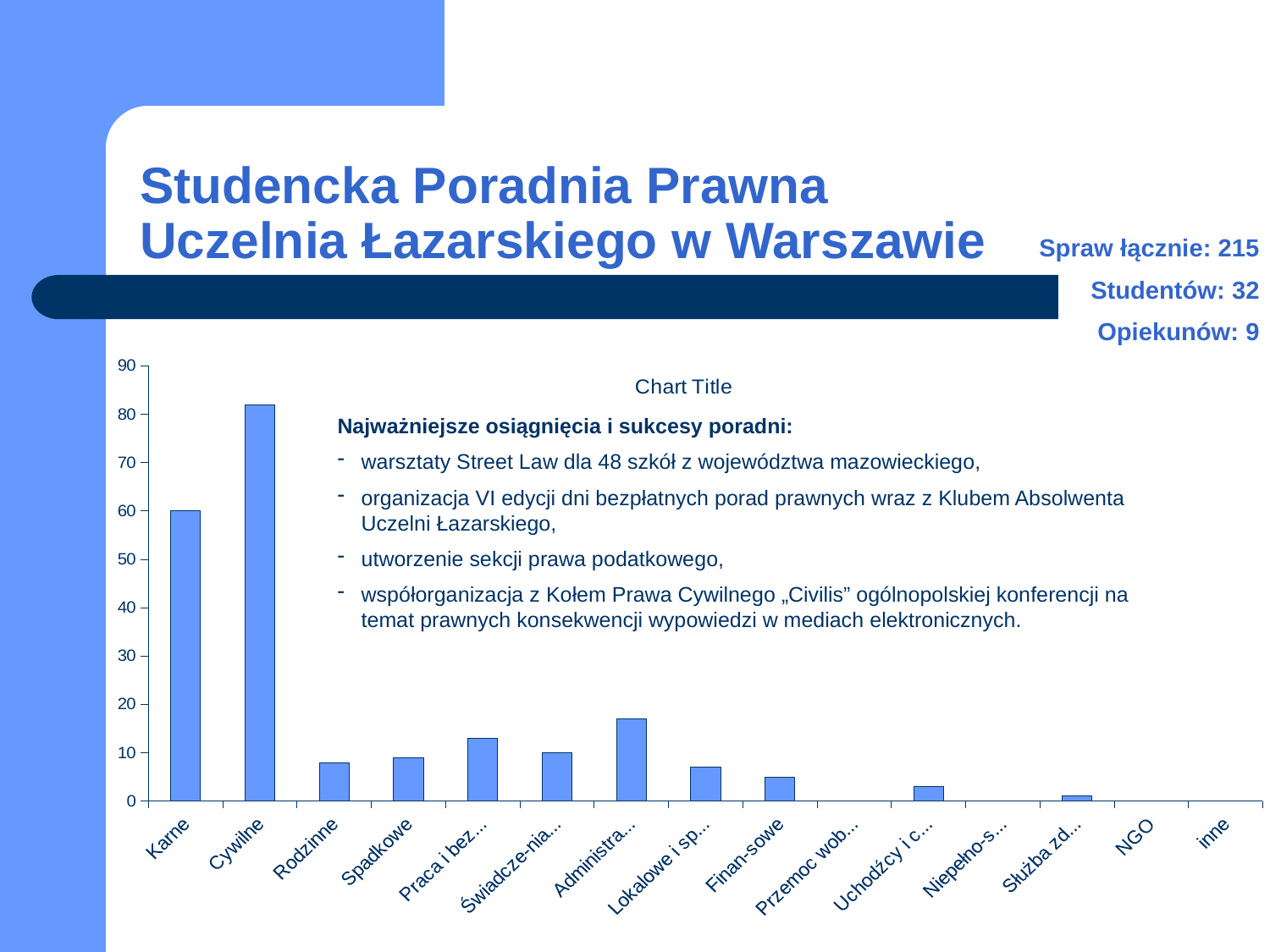
Which category has the highest value in the chart? Cywilne Is the value for Rodzinne greater or less than 10? less Is the value for Administra... greater or less than 10? greater Is the value for Finan-sowe greater or less than 10? less How many categories are shown on the x axis of the chart? 15 Which is larger, the value for Administra... or the value for Praca i bez...? Administra... Which is larger, the value for Karne or the value for Cywilne? Cywilne What kind of chart is shown on the slide? bar chart What is the title shown on the chart? Chart Title